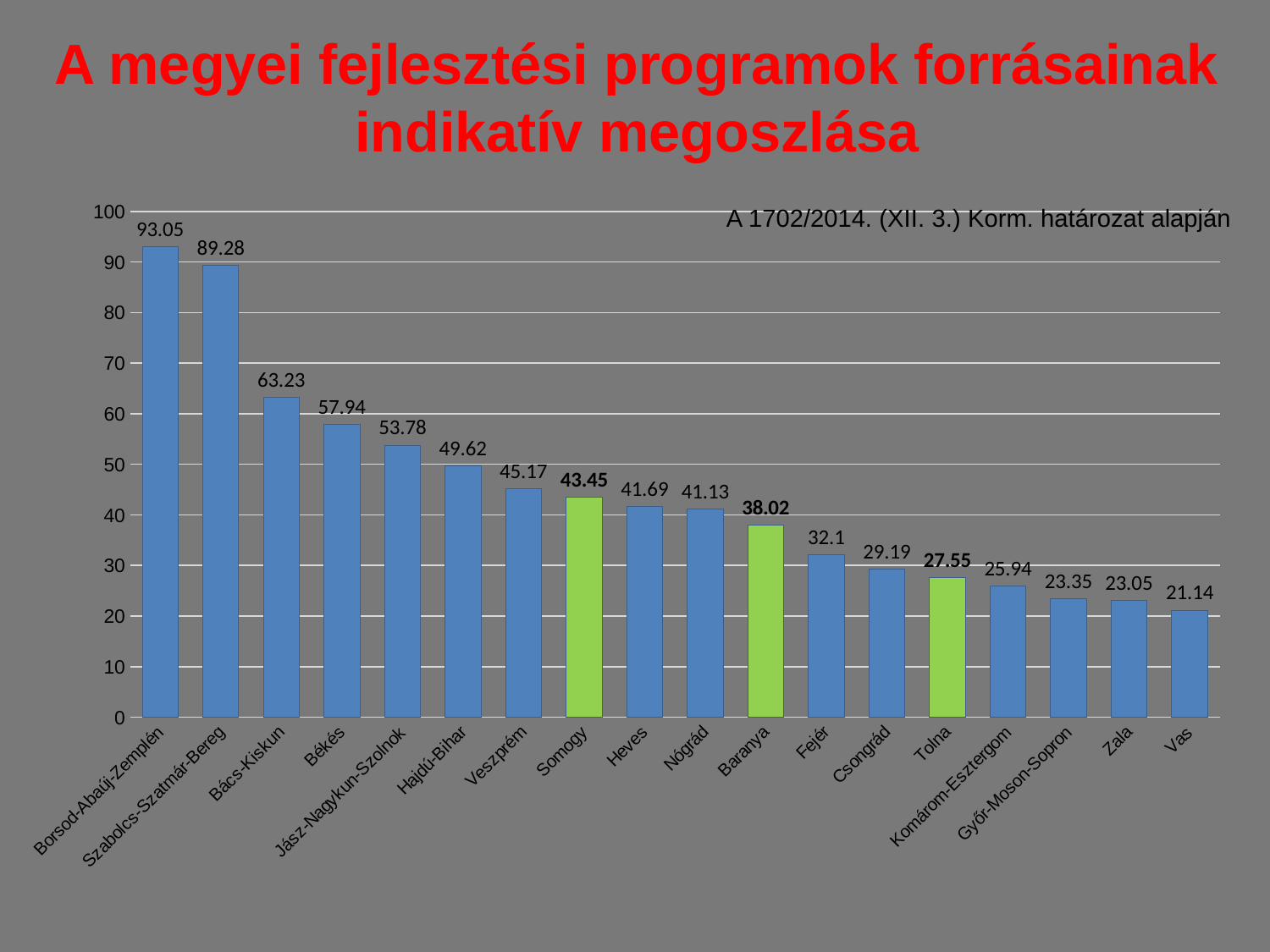
Which county has the lowest value? Vas Which is larger, the value for Bács-Kiskun or the value for Békés? Bács-Kiskun What is the value for Borsod-Abaúj-Zemplén? 93.05 What is the value for Somogy? 43.45 How many bars are coloured green? 3 What kind of chart is shown on the slide? bar chart How many counties are shown on the chart? 18 What is the value for Tolna? 27.55 Which county has the highest value? Borsod-Abaúj-Zemplén Is the value for Hajdú-Bihar greater or less than 50? less What is the difference between the values for Borsod-Abaúj-Zemplén and Szabolcs-Szatmár-Bereg? 3.77 What is the difference between the values for Baranya and Fejér? 5.92